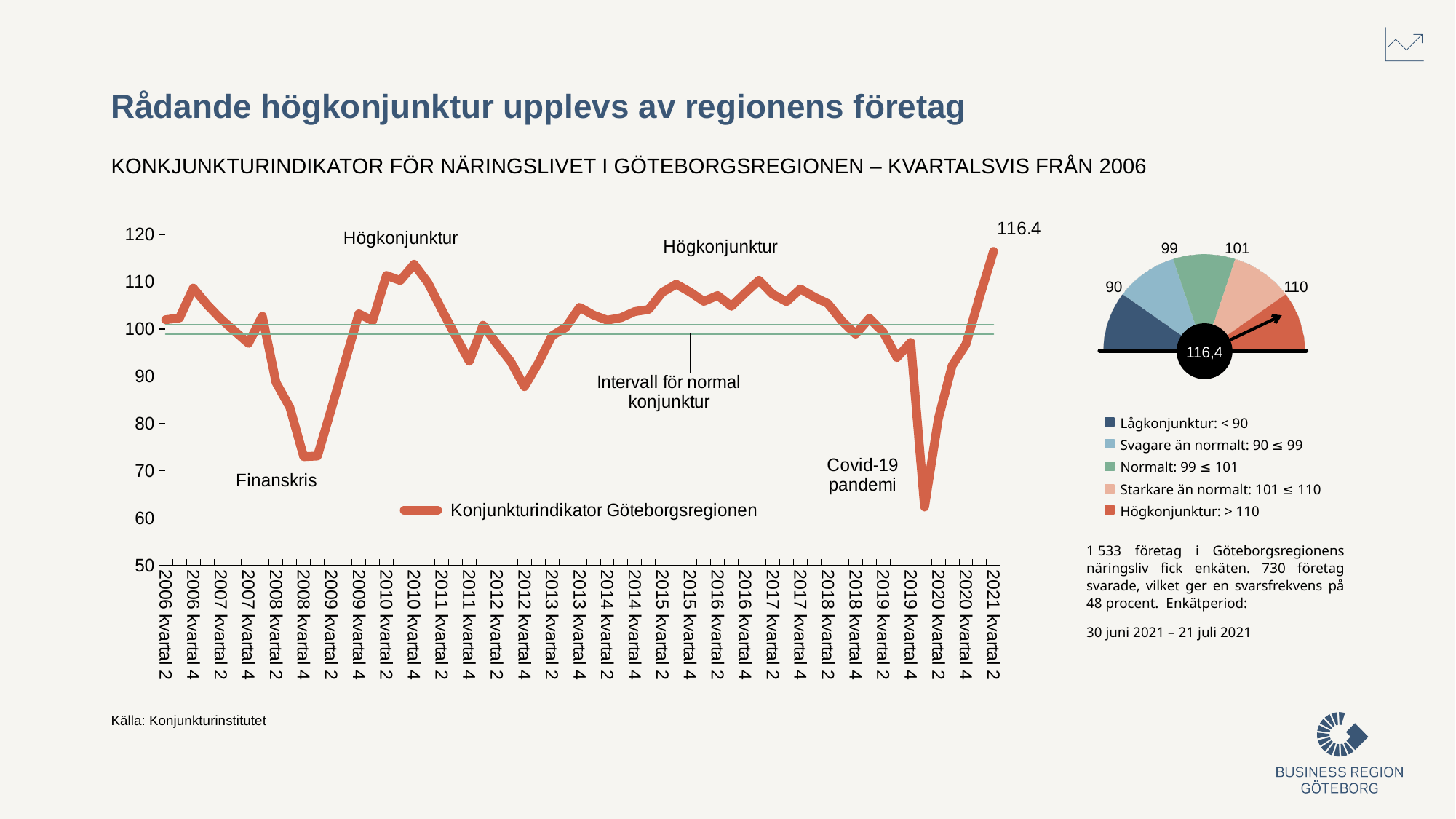
What kind of chart is the large chart on the left of the slide? line chart How many categories does the legend of the gauge chart list? 5 In the line chart, what is the value of the Konjunkturindikator for 2021 kvartal 2? 116.4 In the line chart, does the Konjunkturindikator rise or fall from 2020 kvartal 2 to 2021 kvartal 2? rise In the line chart, which quarter has the lowest value of the Konjunkturindikator? 2020 kvartal 1 In the line chart, is the value for 2020 kvartal 2 greater or less than 70? greater What is the name of the series shown in the legend of the line chart? Konjunkturindikator Göteborgsregionen In the line chart, which quarter has the highest value of the Konjunkturindikator? 2021 kvartal 2 In the line chart, how many series does the legend list? 1 In the line chart, is the value for 2010 kvartal 4 greater or less than 110? greater What value is displayed in the centre of the gauge chart on the right? 116,4 In the line chart, is the value for 2008 kvartal 4 greater or less than 80? less